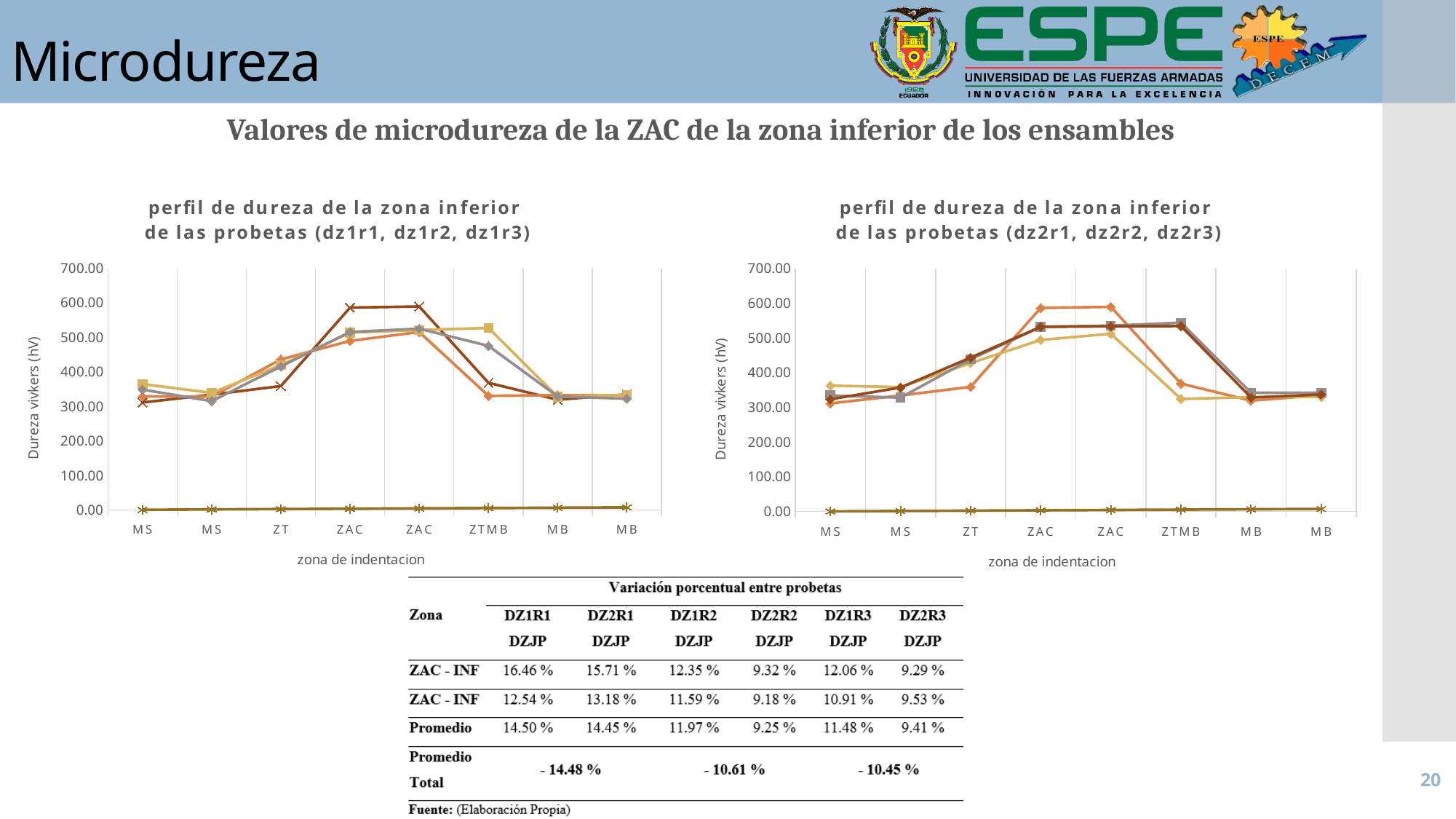
How many indentation zone points are shown along the x axis of the right chart? 8 What is the y-axis label of the left chart? Dureza vivkers (hV) In the left chart, do the hardness values rise or fall from MS to the first ZAC point? rise In the right chart, are the hardness values at the last MB point greater or less than 400? less In the right chart, do the hardness values rise or fall from ZTMB to MB? fall What kind of chart is the right chart, 'perfil de dureza de la zona inferior de las probetas (dz2r1, dz2r2, dz2r3)'? line chart How many indentation zone points are shown along the x axis of the left chart? 8 In the left chart, are the hardness values at the first ZAC point greater or less than 400? greater What kind of chart is the left chart, 'perfil de dureza de la zona inferior de las probetas (dz1r1, dz1r2, dz1r3)'? line chart What is the x-axis label of the right chart? zona de indentacion In the left chart, are the hardness values at the first MS point greater or less than 400? less